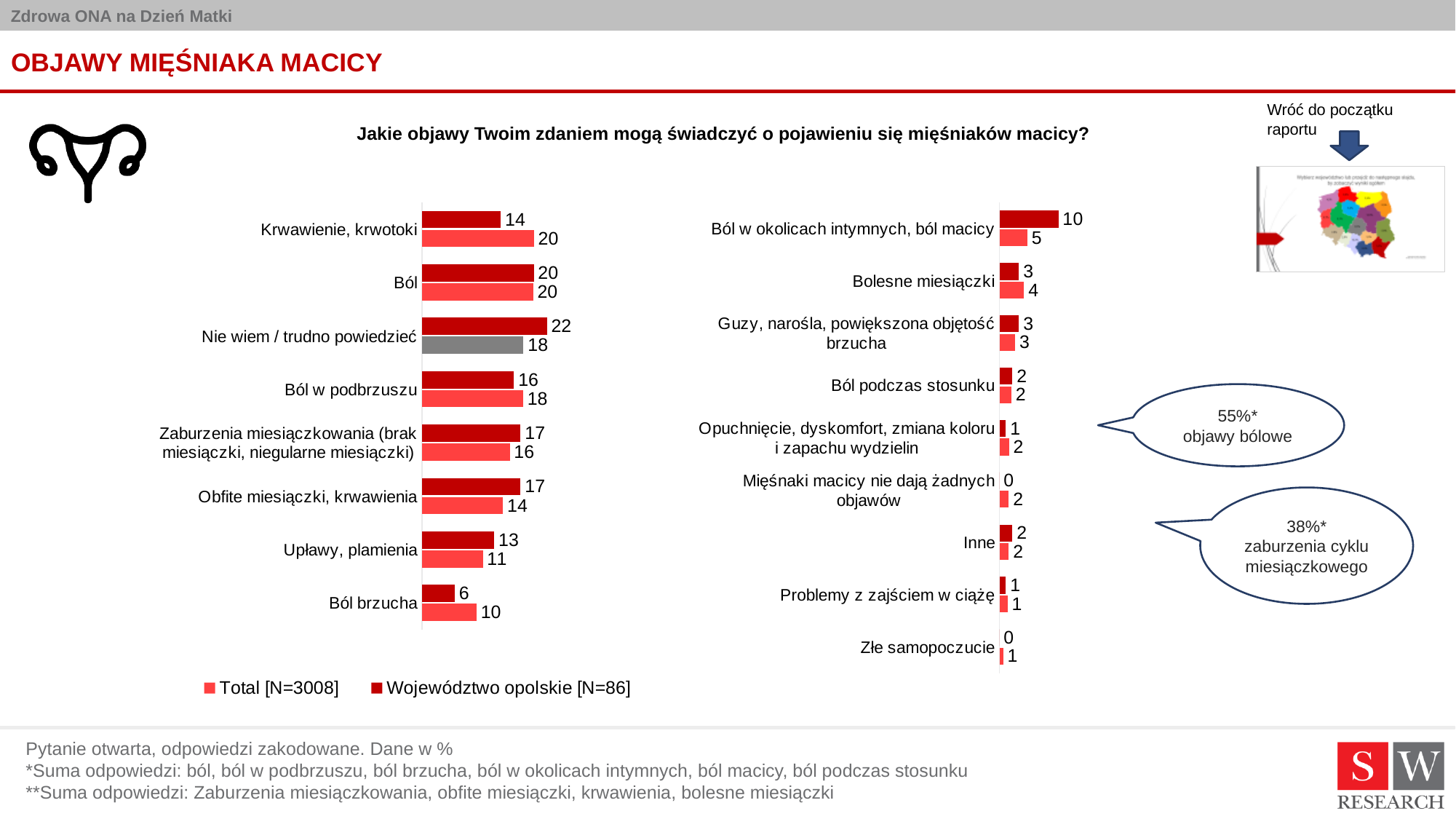
On the left chart, which category has the highest value for Województwo opolskie [N=86]? Nie wiem / trudno powiedzieć How many series does the legend list? 2 On the right chart, what is the difference between the Województwo opolskie [N=86] and Total [N=3008] values for 'Ból w okolicach intymnych, ból macicy'? 5 On the left chart, what is the value for Województwo opolskie [N=86] for 'Ból brzucha'? 6 On the left chart, which is larger for 'Ból brzucha': the Total [N=3008] value or the Województwo opolskie [N=86] value? Total [N=3008] On the left chart, what is the value for Total [N=3008] for 'Krwawienie, krwotoki'? 20 On the right chart, which category has the highest value for Total [N=3008]? Ból w okolicach intymnych, ból macicy On the left chart, which category has the lowest value for Total [N=3008]? Ból brzucha What type of chart is the left chart? Bar chart On the right chart, what is the value for Województwo opolskie [N=86] for 'Ból w okolicach intymnych, ból macicy'? 10 On the left chart, what is the difference between the Total [N=3008] and Województwo opolskie [N=86] values for 'Krwawienie, krwotoki'? 6 How many categories are shown on the right chart? 9